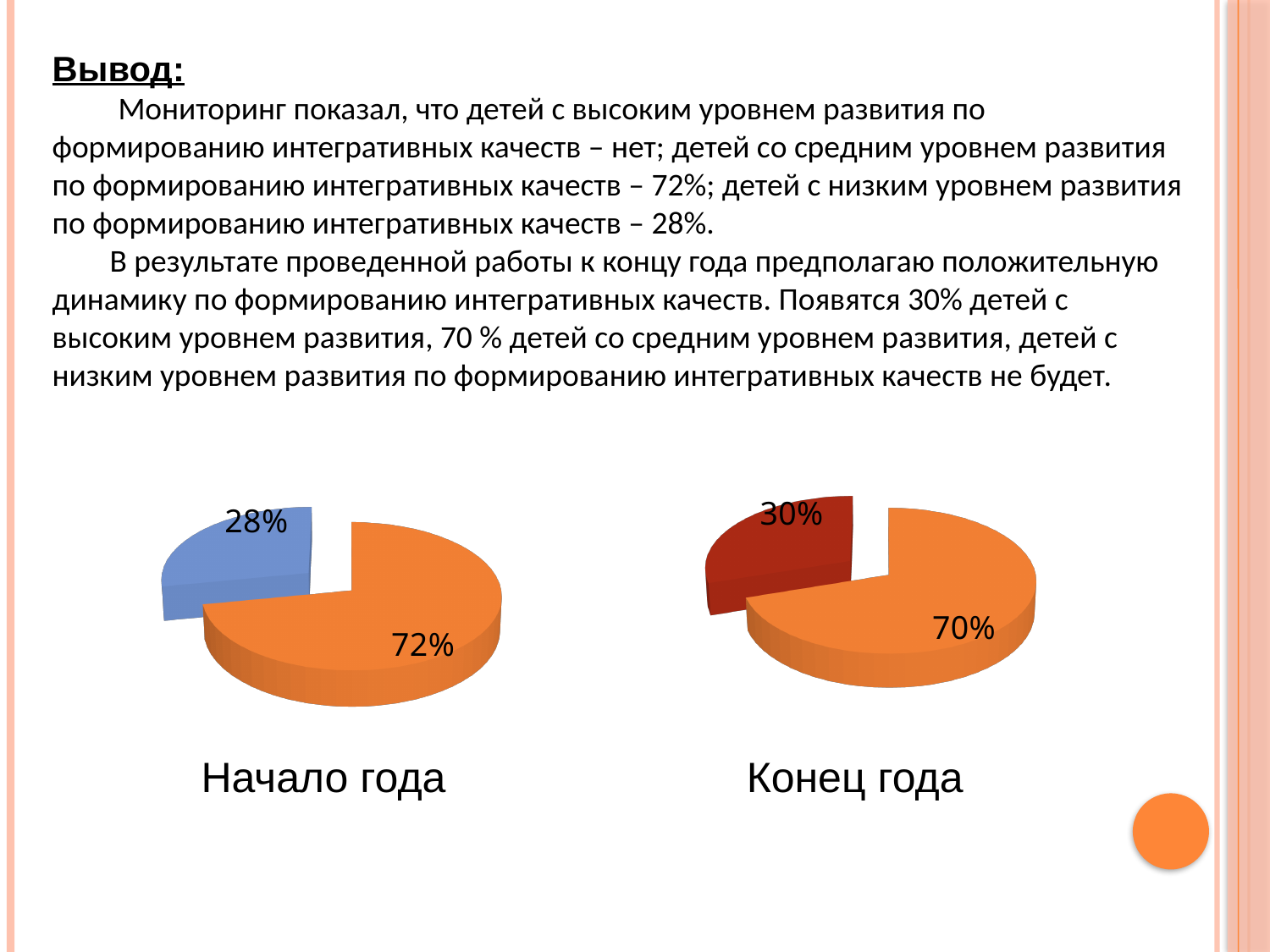
In the "Конец года" pie chart, what is the difference between the two slice values? 40% In the "Конец года" pie chart, what value is shown on the orange slice? 70% Which is larger: the orange slice in the "Начало года" chart or the orange slice in the "Конец года" chart? the orange slice in the "Начало года" chart (72%) In the "Начало года" pie chart, what is the difference between the two slice values? 44% What kind of chart is shown under the label "Начало года"? pie chart In the "Начало года" pie chart, which slice is the largest? the orange slice (72%) In the "Начало года" pie chart, what value is shown on the orange slice? 72% How many slices does the "Начало года" pie chart have? 2 In the "Конец года" pie chart, which slice is the smallest? the dark red slice (30%) In the "Начало года" pie chart, what value is shown on the blue slice? 28% What kind of chart is shown under the label "Конец года"? pie chart In the "Конец года" pie chart, what value is shown on the dark red slice? 30%